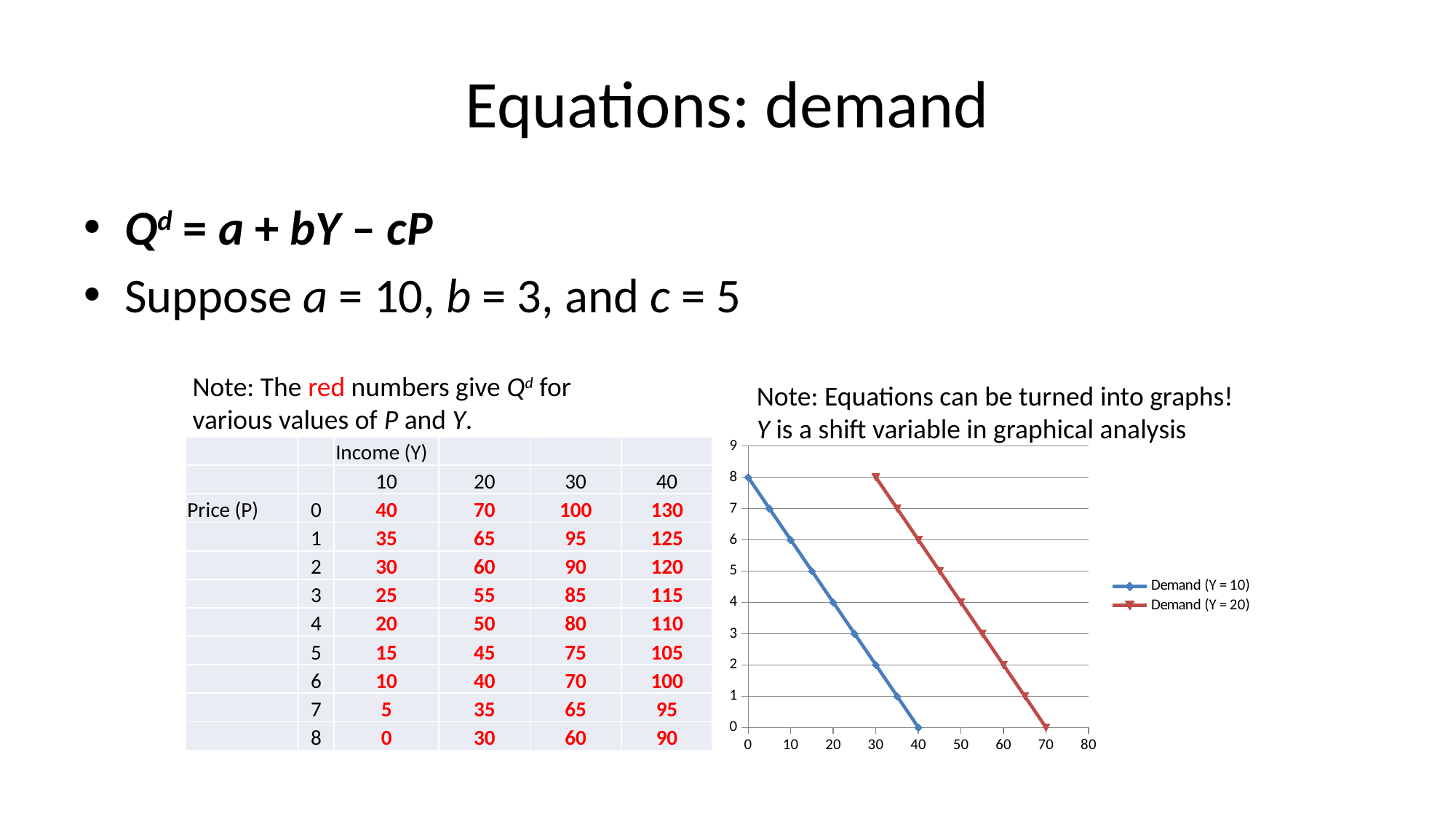
On the chart, what quantity does the Demand (Y = 20) line show at a price of 8? 30 Is the quantity on the Demand (Y = 20) line at a price of 5 greater or less than 40? greater On the chart, what quantity does the Demand (Y = 10) line reach at a price of 0? 40 How many series does the chart's legend list? 2 What kind of chart is shown on the right of the slide? line chart What are the two series named in the chart's legend? Demand (Y = 10) and Demand (Y = 20) At a price of 4, which series shows the larger quantity on the chart? Demand (Y = 20) As quantity increases along the x axis, does the price on each demand line rise or fall? fall At a price of 0, what is the difference in quantity between the Demand (Y = 20) line and the Demand (Y = 10) line? 30 On the chart, what quantity does the Demand (Y = 10) line show at a price of 8? 0 How many data points are plotted on the Demand (Y = 10) line? 9 On the chart, what quantity does the Demand (Y = 20) line reach at a price of 0? 70